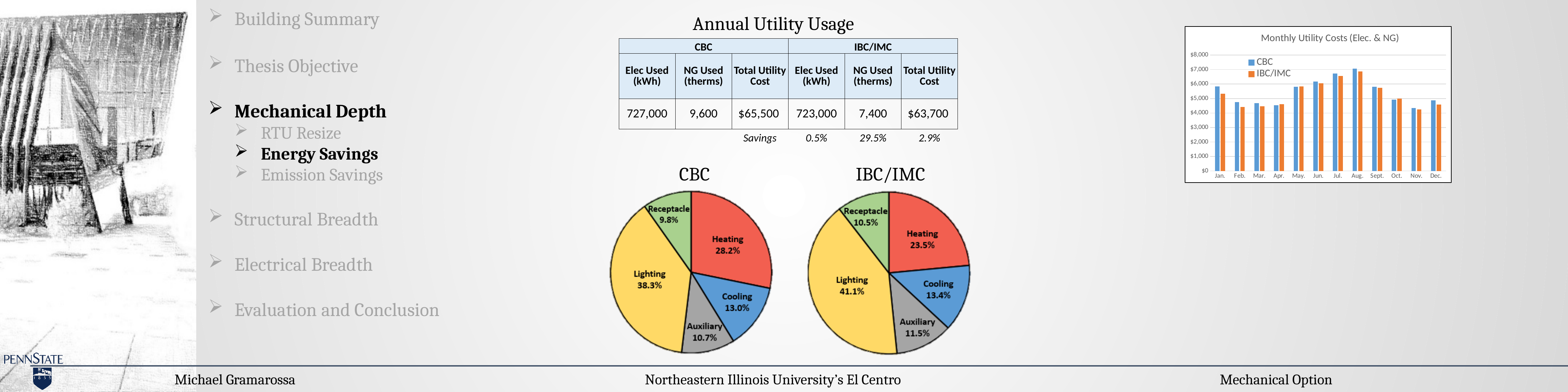
In the CBC pie chart, which category has the largest share? Lighting In the Monthly Utility Costs (Elec. & NG) chart, is the CBC value for Nov. greater or less than $5,000? less In the CBC pie chart, what is the difference between the Heating and Cooling shares? 15.2% In the Monthly Utility Costs (Elec. & NG) chart, which month has the highest CBC cost? Aug. What kind of chart is the Monthly Utility Costs (Elec. & NG) chart? bar chart In the IBC/IMC pie chart, which category has the smallest share? Receptacle How many categories are shown in the CBC pie chart? 5 In the CBC pie chart, what share does Lighting have? 38.3% In the Monthly Utility Costs (Elec. & NG) chart, is the CBC value for Jul. greater or less than $6,000? greater In the IBC/IMC pie chart, what share does Heating have? 23.5% In the IBC/IMC pie chart, which is larger, Cooling or Auxiliary? Cooling How many series does the legend of the Monthly Utility Costs (Elec. & NG) chart list? 2